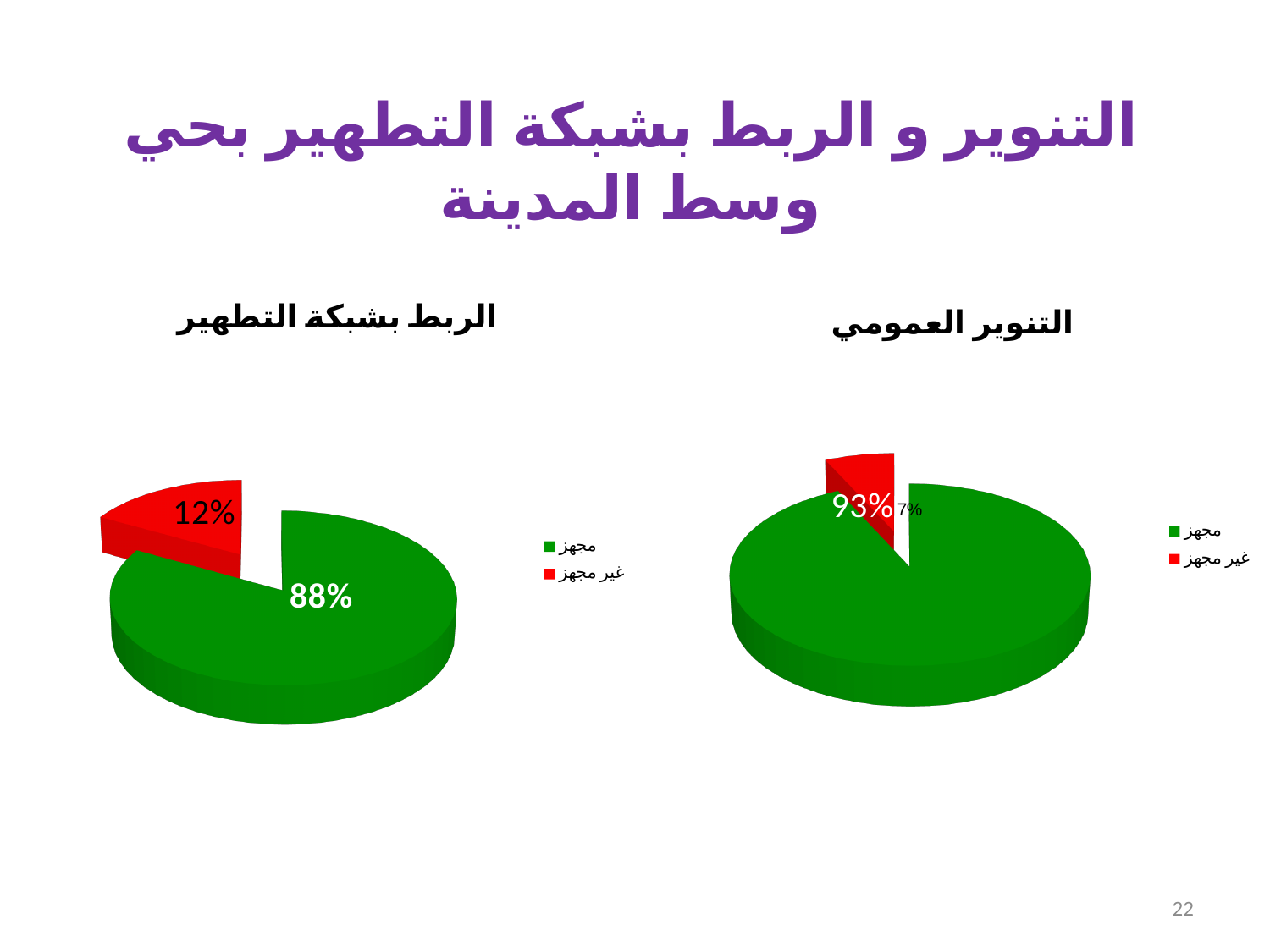
In the chart titled "الربط بشبكة التطهير", what is the difference between the "مجهز" and "غير مجهز" shares? 76% What kind of chart is the chart titled "الربط بشبكة التطهير"? Pie chart In the chart titled "الربط بشبكة التطهير", which category has the largest slice? مجهز What kind of chart is the chart titled "التنوير العمومي"? Pie chart How many slices does the chart titled "التنوير العمومي" have? 2 In the chart titled "الربط بشبكة التطهير", what share of the pie is labelled "غير مجهز"? 12% In the chart titled "التنوير العمومي", what share of the pie is labelled "غير مجهز"? 7% Which chart has the larger "غير مجهز" share, "الربط بشبكة التطهير" or "التنوير العمومي"? الربط بشبكة التطهير In the chart titled "التنوير العمومي", what share of the pie is labelled "مجهز"? 93% In the chart titled "الربط بشبكة التطهير", what colour is the "غير مجهز" slice? Red In the chart titled "التنوير العمومي", which category has the smallest slice? غير مجهز